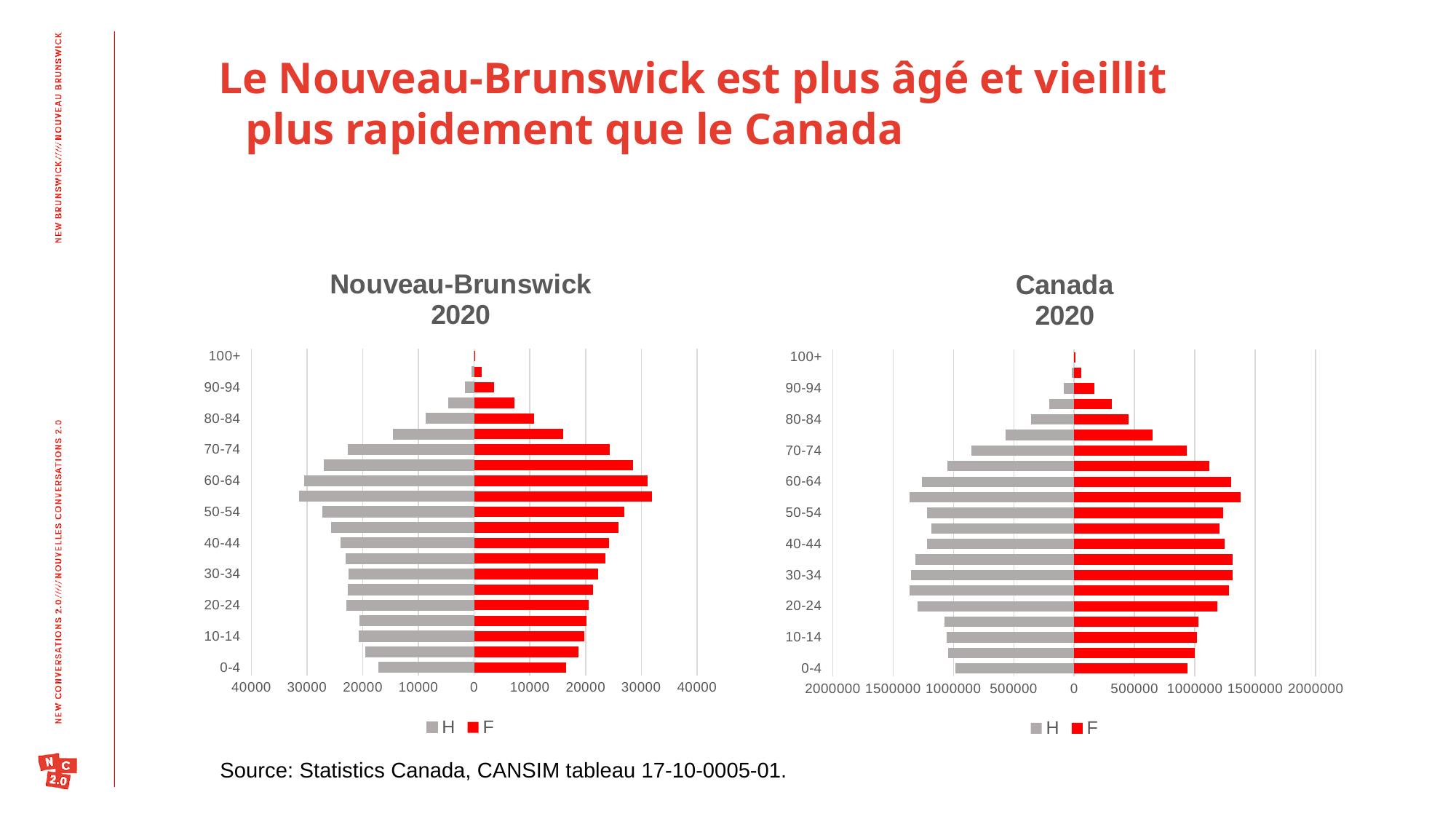
In the Nouveau-Brunswick 2020 chart, is the H value for the 80-84 age group greater or less than 10000? less In the Nouveau-Brunswick 2020 chart, is the F value for the 70-74 age group greater or less than 20000? greater In the Nouveau-Brunswick 2020 chart, is the H value for the 0-4 age group greater or less than 20000? less How many series does the legend of the Canada 2020 chart list? 2 What is the title of the chart on the right of the slide? Canada 2020 In the Nouveau-Brunswick 2020 chart, which is larger: the H value for 0-4 or the H value for 70-74? 70-74 In the Canada 2020 chart, which labelled age group has the smallest F value? 100+ In the Canada 2020 chart, do the H bars get longer or shorter as the age groups go from 60-64 up to 100+? shorter In the Nouveau-Brunswick 2020 chart, which colour represents the F series? red What kind of chart is the Nouveau-Brunswick 2020 chart? bar chart